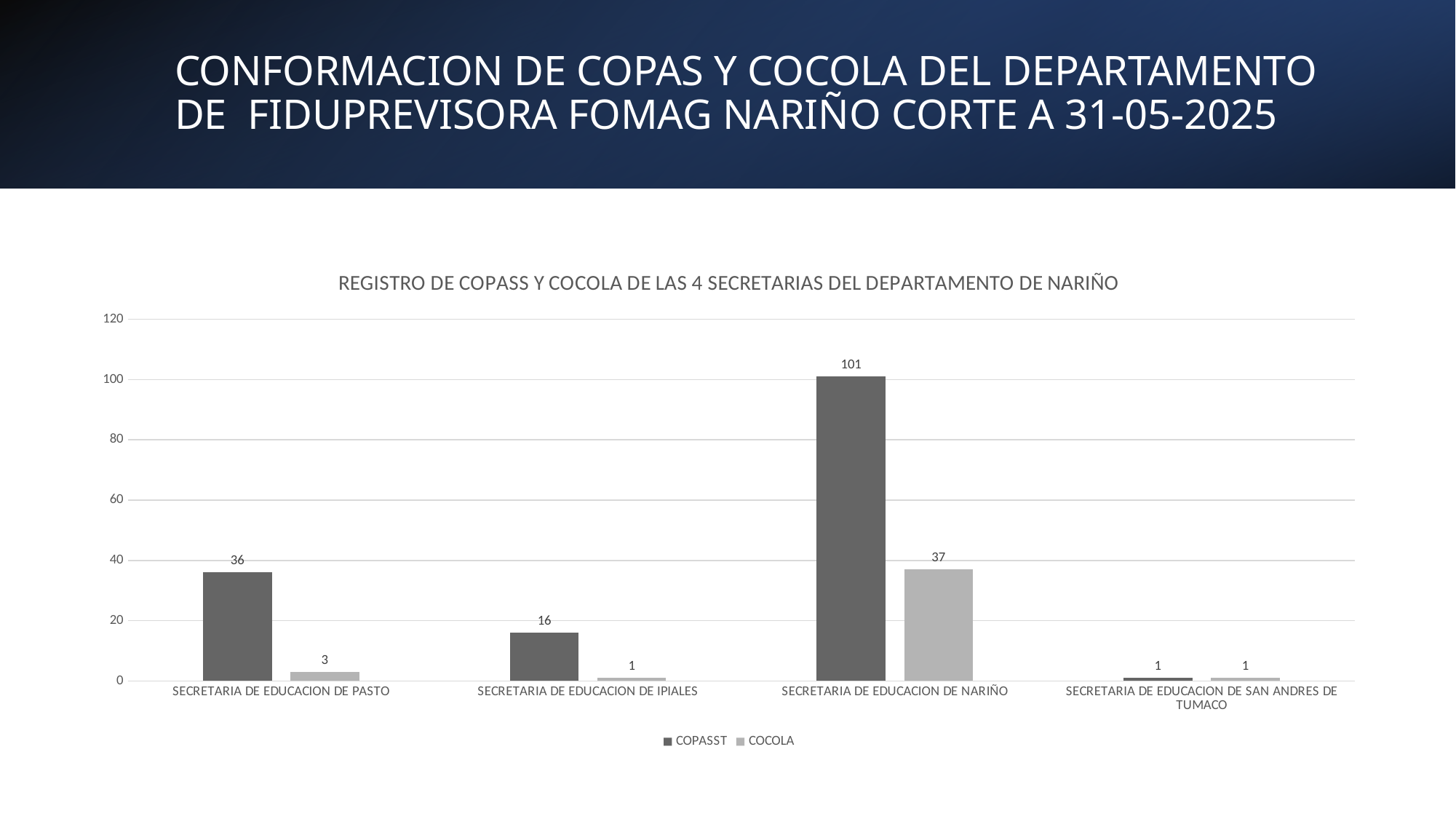
What is the difference between the COPASST and COCOLA values for SECRETARIA DE EDUCACION DE NARIÑO? 64 How many categories are shown on the x axis? 4 What is the COPASST value for SECRETARIA DE EDUCACION DE IPIALES? 16 Which category has the highest COPASST value? SECRETARIA DE EDUCACION DE NARIÑO Which category has the lowest COPASST value? SECRETARIA DE EDUCACION DE SAN ANDRES DE TUMACO What is the COPASST value for SECRETARIA DE EDUCACION DE PASTO? 36 What is the COCOLA value for SECRETARIA DE EDUCACION DE NARIÑO? 37 How many series does the legend list? 2 Is the COPASST value for SECRETARIA DE EDUCACION DE NARIÑO greater or less than 100? greater What is the title of the chart? REGISTRO DE COPASS Y COCOLA DE LAS 4 SECRETARIAS DEL DEPARTAMENTO DE NARIÑO Which is larger: the COPASST value for SECRETARIA DE EDUCACION DE PASTO or the COPASST value for SECRETARIA DE EDUCACION DE IPIALES? SECRETARIA DE EDUCACION DE PASTO What kind of chart is shown on the slide? bar chart